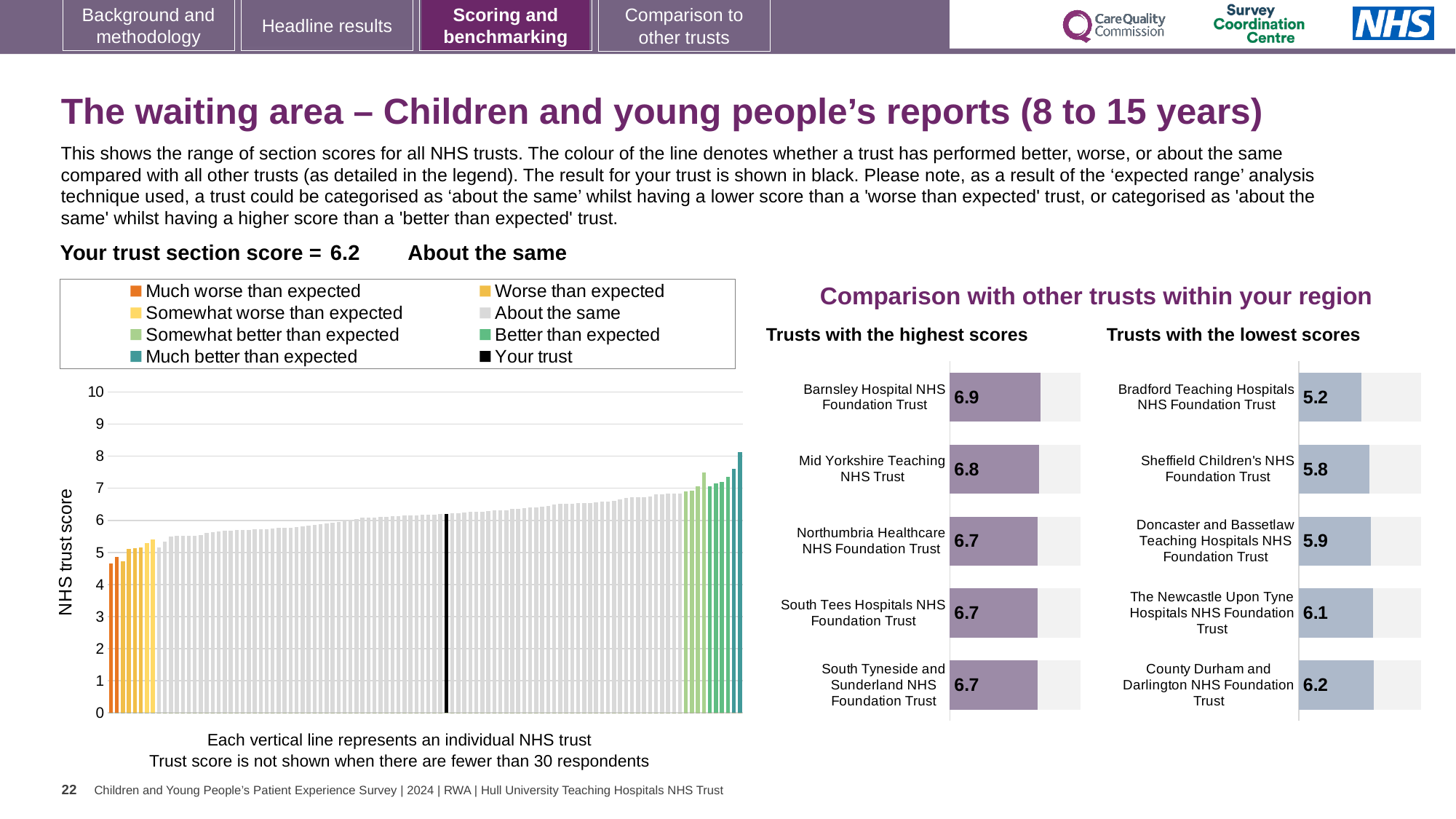
In the main chart on the left, is the value for the lowest-scoring trust (the leftmost bar) greater or less than 5? less In the 'Trusts with the lowest scores' chart, what is the score for Bradford Teaching Hospitals NHS Foundation Trust? 5.2 In the 'Trusts with the lowest scores' chart, what is the score for The Newcastle Upon Tyne Hospitals NHS Foundation Trust? 6.1 How many trusts are shown in the 'Trusts with the highest scores' chart? 5 In the 'Trusts with the lowest scores' chart, what is the difference between the scores of County Durham and Darlington NHS Foundation Trust and Bradford Teaching Hospitals NHS Foundation Trust? 1.0 In the 'Trusts with the highest scores' chart, which trust has the highest score? Barnsley Hospital NHS Foundation Trust How many entries does the legend of the main chart on the left list? 8 In the main chart on the left, do the trust scores rise or fall from left to right along the x axis? rise In the 'Trusts with the lowest scores' chart, which trust has the lowest score? Bradford Teaching Hospitals NHS Foundation Trust In the 'Trusts with the highest scores' chart, what is the score for Barnsley Hospital NHS Foundation Trust? 6.9 In the 'Trusts with the highest scores' chart, what is the score for Mid Yorkshire Teaching NHS Trust? 6.8 In the 'Trusts with the lowest scores' chart, which has the higher score: Sheffield Children's NHS Foundation Trust or Doncaster and Bassetlaw Teaching Hospitals NHS Foundation Trust? Doncaster and Bassetlaw Teaching Hospitals NHS Foundation Trust